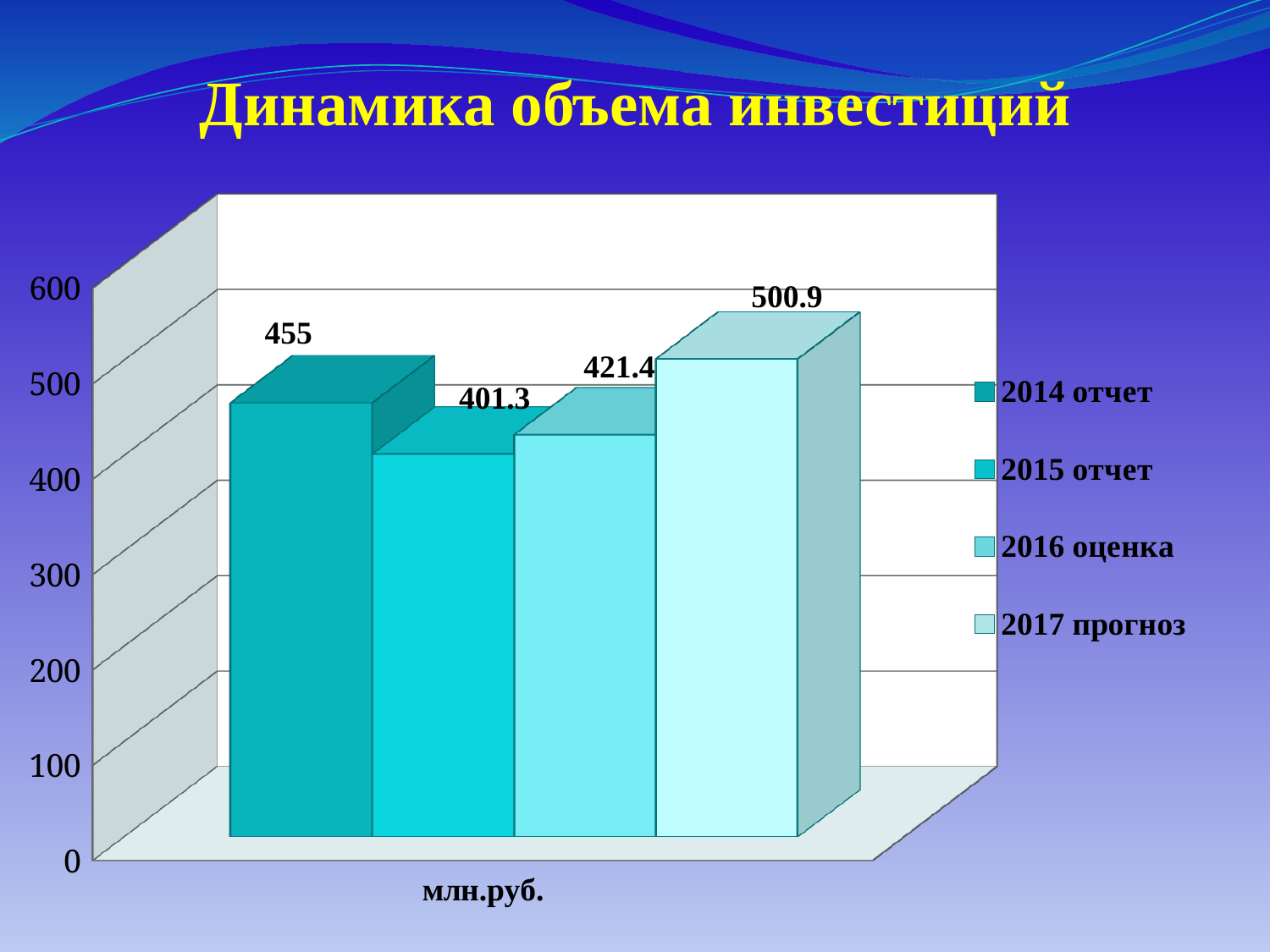
What is the value for 2016 оценка? 421.4 Which series has the lowest value? 2015 отчет What is the value for 2015 отчет? 401.3 What is the value for 2017 прогноз? 500.9 Which series has the highest value? 2017 прогноз Which is larger, the value for 2014 отчет or the value for 2016 оценка? 2014 отчет How many series does the legend list? 4 What is the difference between the values for 2017 прогноз and 2015 отчет? 99.6 What kind of chart is shown on the slide? bar chart What is the value for 2014 отчет? 455 What is the title of the chart? Динамика объема инвестиций What is the difference between the values for 2014 отчет and 2016 оценка? 33.6